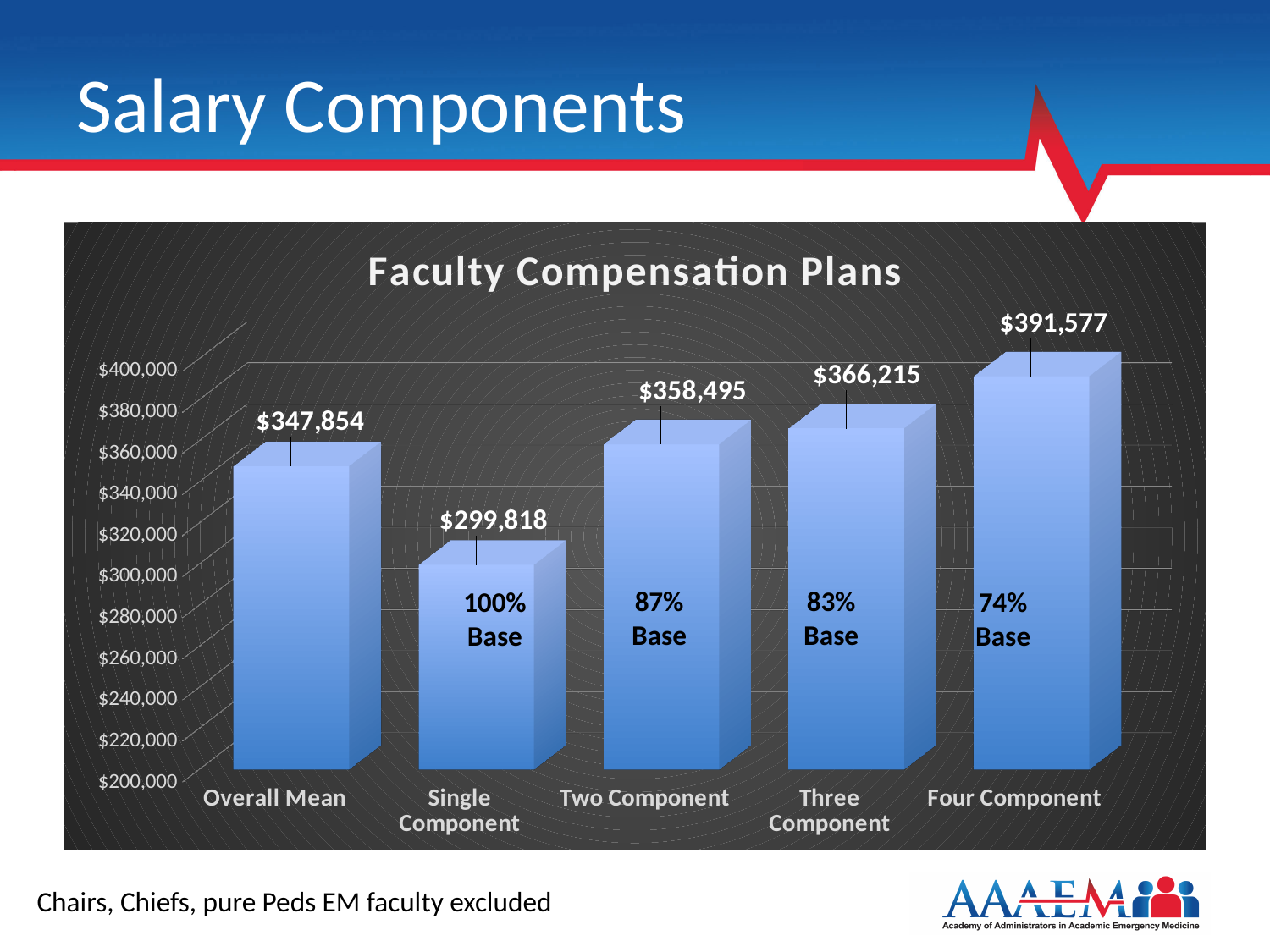
Which category has the lowest value? Single Component What is the title of the chart? Faculty Compensation Plans How many categories are shown on the x axis? 5 Which category has the highest value? Four Component Is the value for Three Component greater or less than $340,000? greater What is the value for Overall Mean? $347,854 What is the value for Single Component? $299,818 What kind of chart is this? bar chart What is the difference between the Three Component and Two Component values? $7,720 What is the difference between the Four Component and Single Component values? $91,759 What is the value for Four Component? $391,577 Which is larger, the value for Two Component or the value for Overall Mean? Two Component